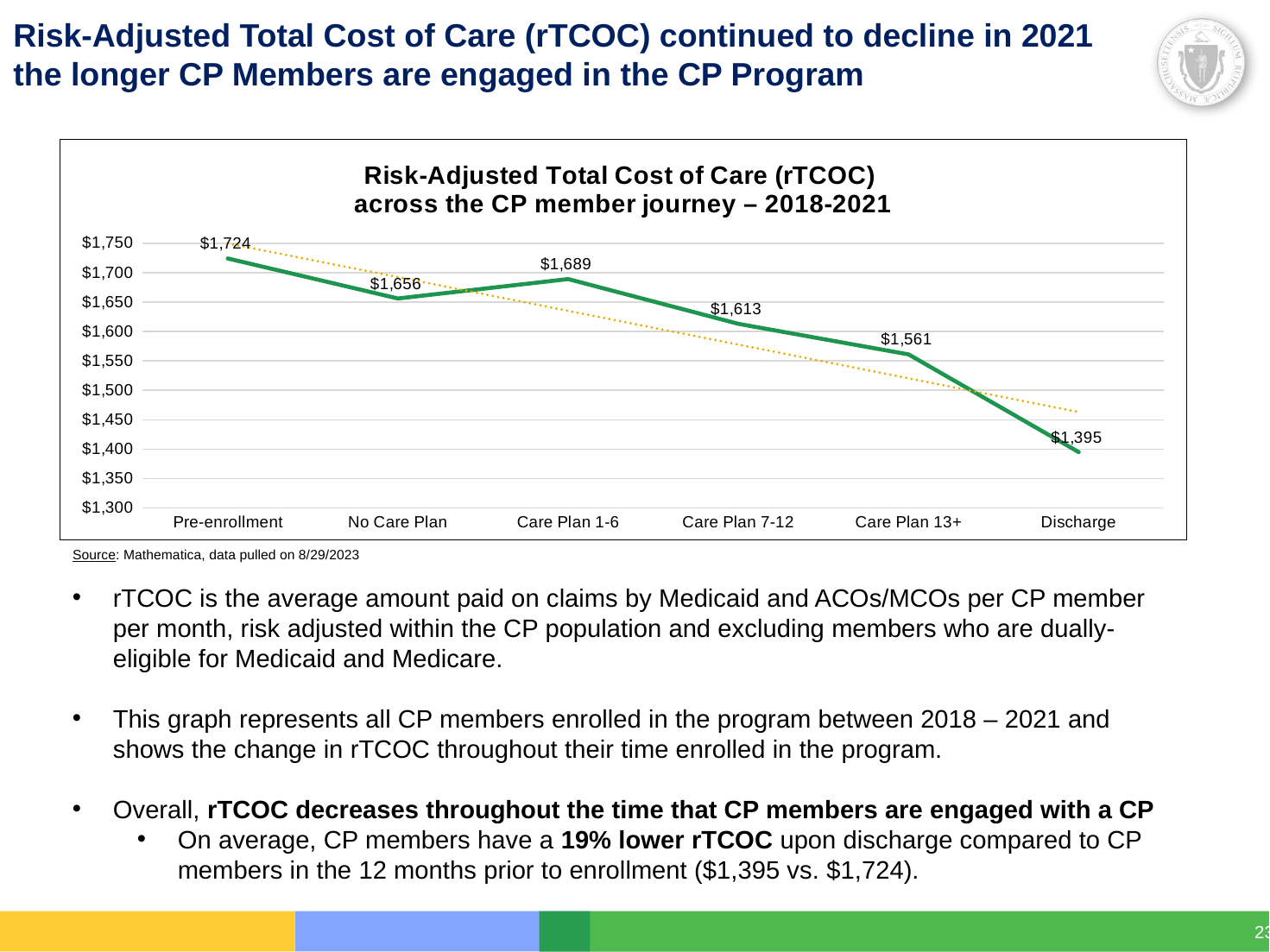
Is the rTCOC value for Care Plan 13+ greater or less than $1,600? less What is the difference in rTCOC between Pre-enrollment and Discharge? $329 How many stages of the CP member journey are plotted on the x axis? 6 What kind of chart is shown on the slide? Line chart Which has a higher rTCOC, No Care Plan or Care Plan 1-6? Care Plan 1-6 What is the difference in rTCOC between Care Plan 1-6 and No Care Plan? $33 What is the rTCOC value for Pre-enrollment? $1,724 Which stage of the CP member journey has the lowest rTCOC? Discharge What is the overall trend of rTCOC from Pre-enrollment to Discharge? Falling What is the rTCOC value at Discharge? $1,395 What is the rTCOC value for Care Plan 7-12? $1,613 Which stage of the CP member journey has the highest rTCOC? Pre-enrollment